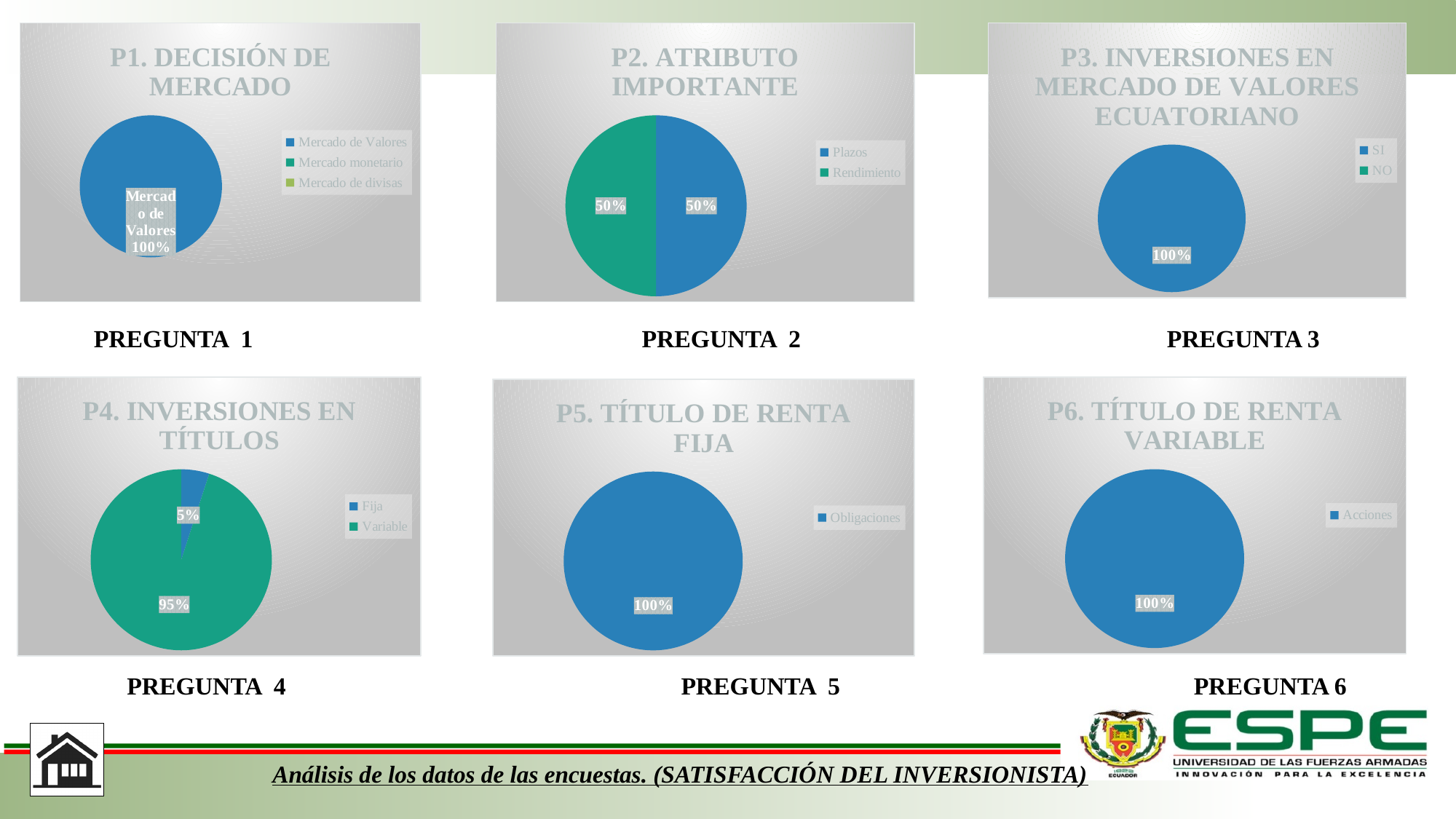
In the chart titled "P4. INVERSIONES EN TÍTULOS", what is the difference between the Variable and Fija shares? 90% In the chart titled "P3. INVERSIONES EN MERCADO DE VALORES ECUATORIANO", what share does SI have? 100% In the chart titled "P5. TÍTULO DE RENTA FIJA", what share does Obligaciones have? 100% Which two entries does the legend list in the chart titled "P3. INVERSIONES EN MERCADO DE VALORES ECUATORIANO"? SI and NO What kind of chart is the one titled "P2. ATRIBUTO IMPORTANTE"? Pie chart In the chart titled "P4. INVERSIONES EN TÍTULOS", what share does Fija have? 5% In the chart titled "P4. INVERSIONES EN TÍTULOS", which category has the largest slice? Variable In the chart titled "P2. ATRIBUTO IMPORTANTE", what is the difference between the Plazos and Rendimiento shares? 0% How many entries does the legend list in the chart titled "P1. DECISIÓN DE MERCADO"? 3